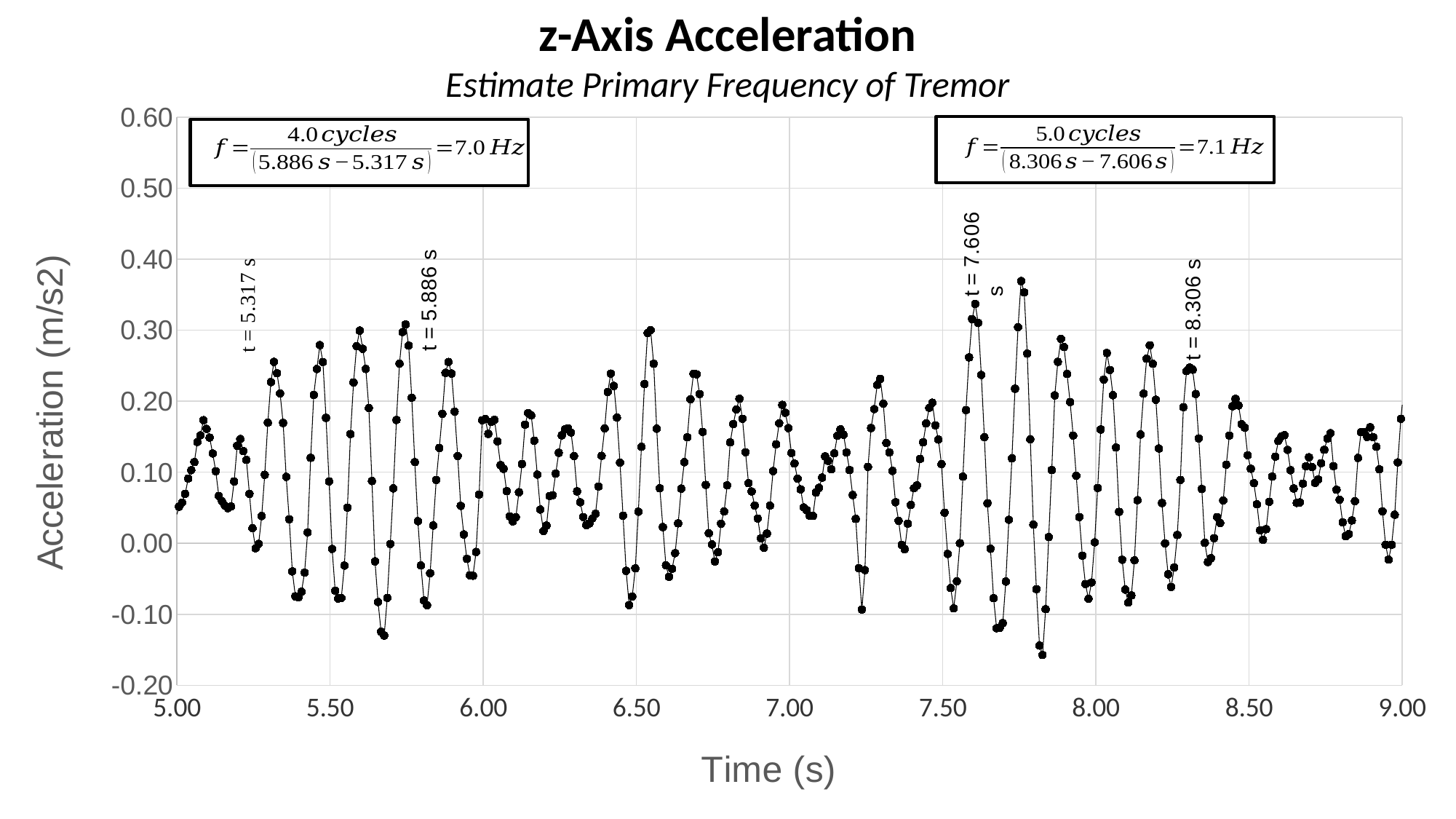
Is the acceleration at the peak marked t = 7.606 s greater or less than 0.30? greater Is the lowest acceleration value on the chart, near 7.8 s, greater or less than -0.10? less What is the label of the vertical axis? Acceleration (m/s2) How many cycles are counted in the left annotation box? 4.0 cycles What time is marked by the last (rightmost) vertical annotation on the chart? t = 8.306 s What is the title of the chart? z-Axis Acceleration What kind of chart is shown on the slide? line chart Which peak is higher: the one marked t = 5.317 s or the one just before 7.80 s? the one just before 7.80 s How many cycles are counted in the right annotation box? 5.0 cycles What time is marked by the first (leftmost) vertical annotation on the chart? t = 5.317 s What frequency is given in the left annotation box? 7.0 Hz What frequency is given in the right annotation box? 7.1 Hz